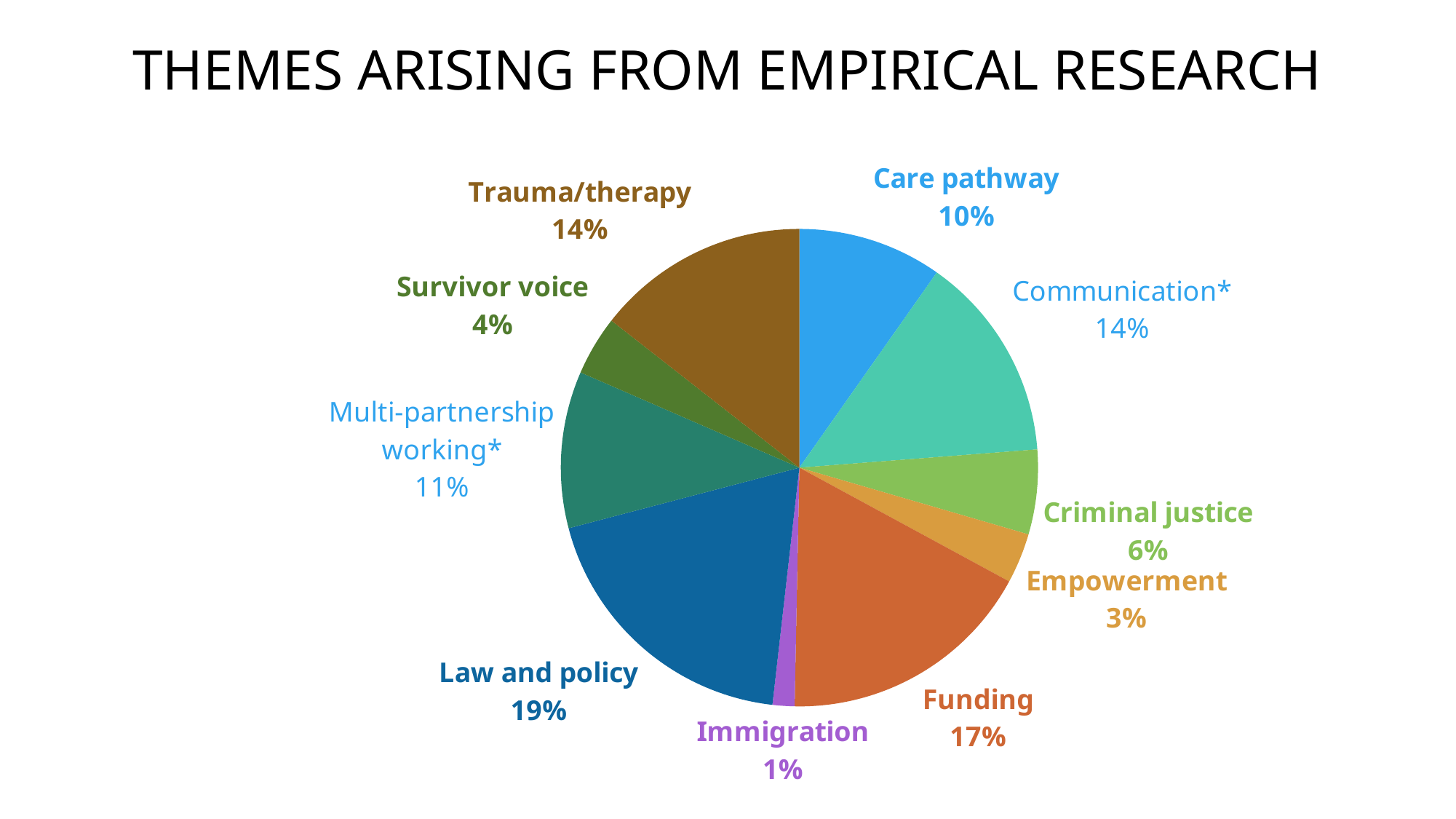
Which theme has the largest share of the pie? Law and policy What is the difference in percentage points between Law and policy and Care pathway? 9 What percentage is shown for Multi-partnership working*? 11% What share of the pie is Law and policy? 19% What percentage is shown for Empowerment? 3% How many slices does the pie chart have? 10 What is the title of the chart? THEMES ARISING FROM EMPIRICAL RESEARCH What is the combined share of Trauma/therapy and Communication*? 28% What kind of chart is shown on the slide? Pie chart What percentage is shown for Funding? 17% Which theme has the smallest share of the pie? Immigration Which has a larger share, Criminal justice or Survivor voice? Criminal justice